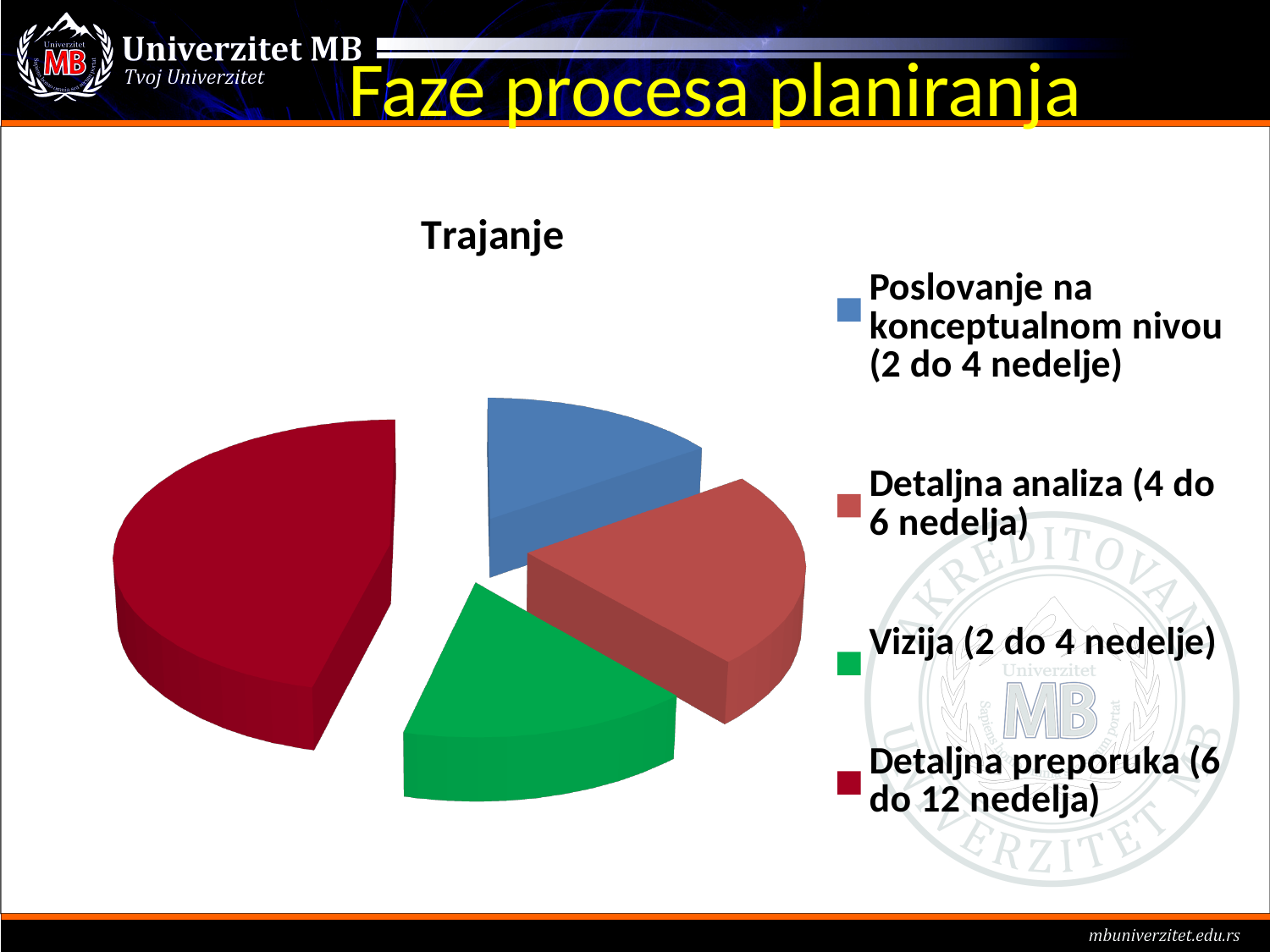
How many slices does the pie chart have? 4 Which slice is larger: Detaljna analiza (4 do 6 nedelja) or Poslovanje na konceptualnom nivou (2 do 4 nedelje)? Detaljna analiza (4 do 6 nedelja) What kind of chart is shown on the slide? pie chart How many entries does the chart legend list? 4 Which category has the largest slice of the pie? Detaljna preporuka (6 do 12 nedelja) Which category is shown in green in the pie chart? Vizija (2 do 4 nedelje) Which slice is larger: Detaljna analiza (4 do 6 nedelja) or Vizija (2 do 4 nedelje)? Detaljna analiza (4 do 6 nedelja) Which slice is larger: Detaljna preporuka (6 do 12 nedelja) or Detaljna analiza (4 do 6 nedelja)? Detaljna preporuka (6 do 12 nedelja) What is the title of the chart? Trajanje